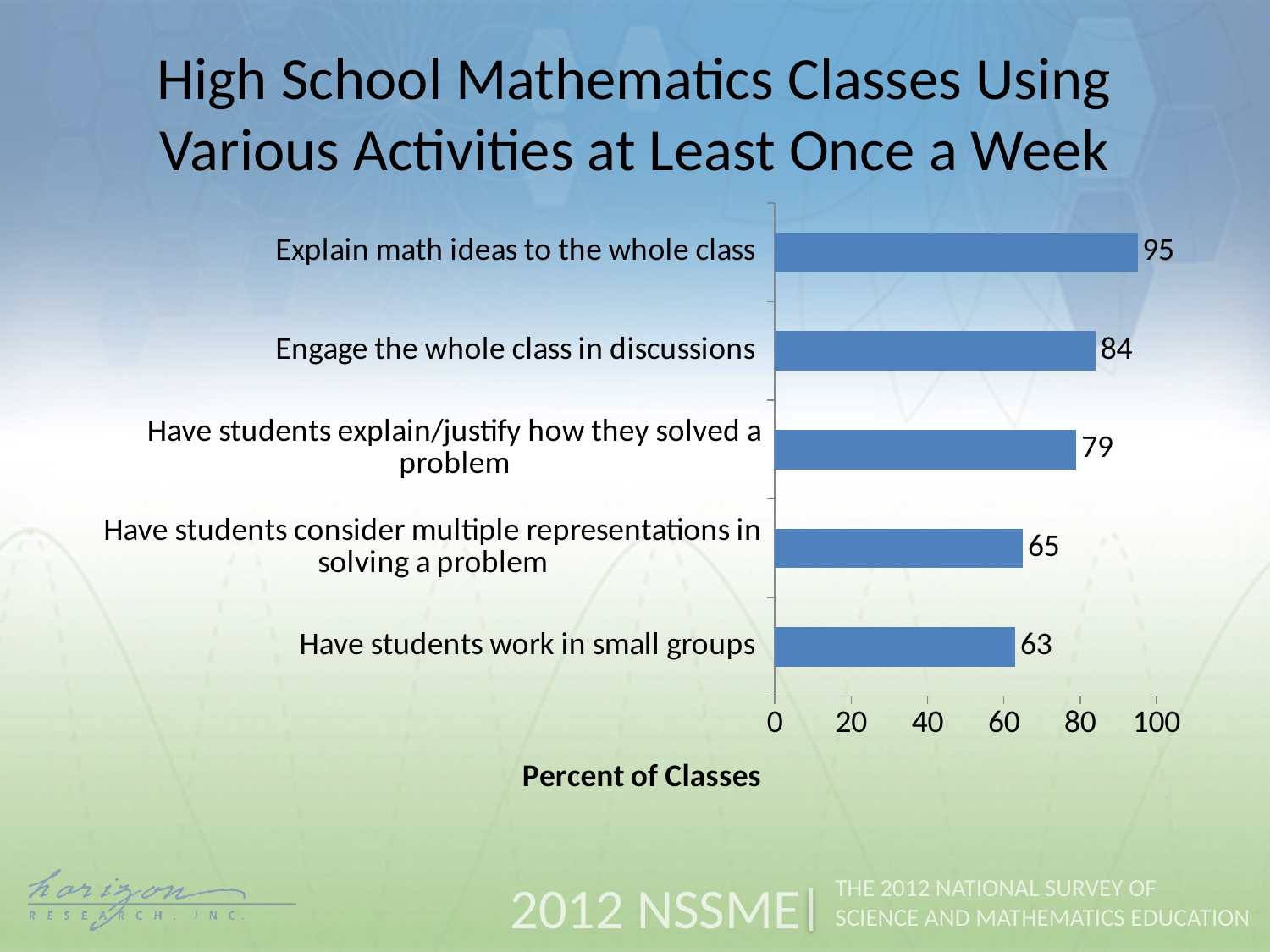
What kind of chart is shown on the slide? Bar chart How many activities are shown in the chart? 5 Which activity has the highest percent of classes? Explain math ideas to the whole class What is the difference between the values for 'Explain math ideas to the whole class' and 'Have students work in small groups'? 32 What is the value for 'Have students consider multiple representations in solving a problem'? 65 What is the difference between the values for 'Engage the whole class in discussions' and 'Have students explain/justify how they solved a problem'? 5 What is the label of the horizontal axis? Percent of Classes What is the value for 'Have students work in small groups'? 63 Which is larger: the value for 'Have students explain/justify how they solved a problem' or 'Have students consider multiple representations in solving a problem'? Have students explain/justify how they solved a problem Which activity has the lowest percent of classes? Have students work in small groups What percent of classes have students explain math ideas to the whole class at least once a week? 95 What is the value for 'Engage the whole class in discussions'? 84